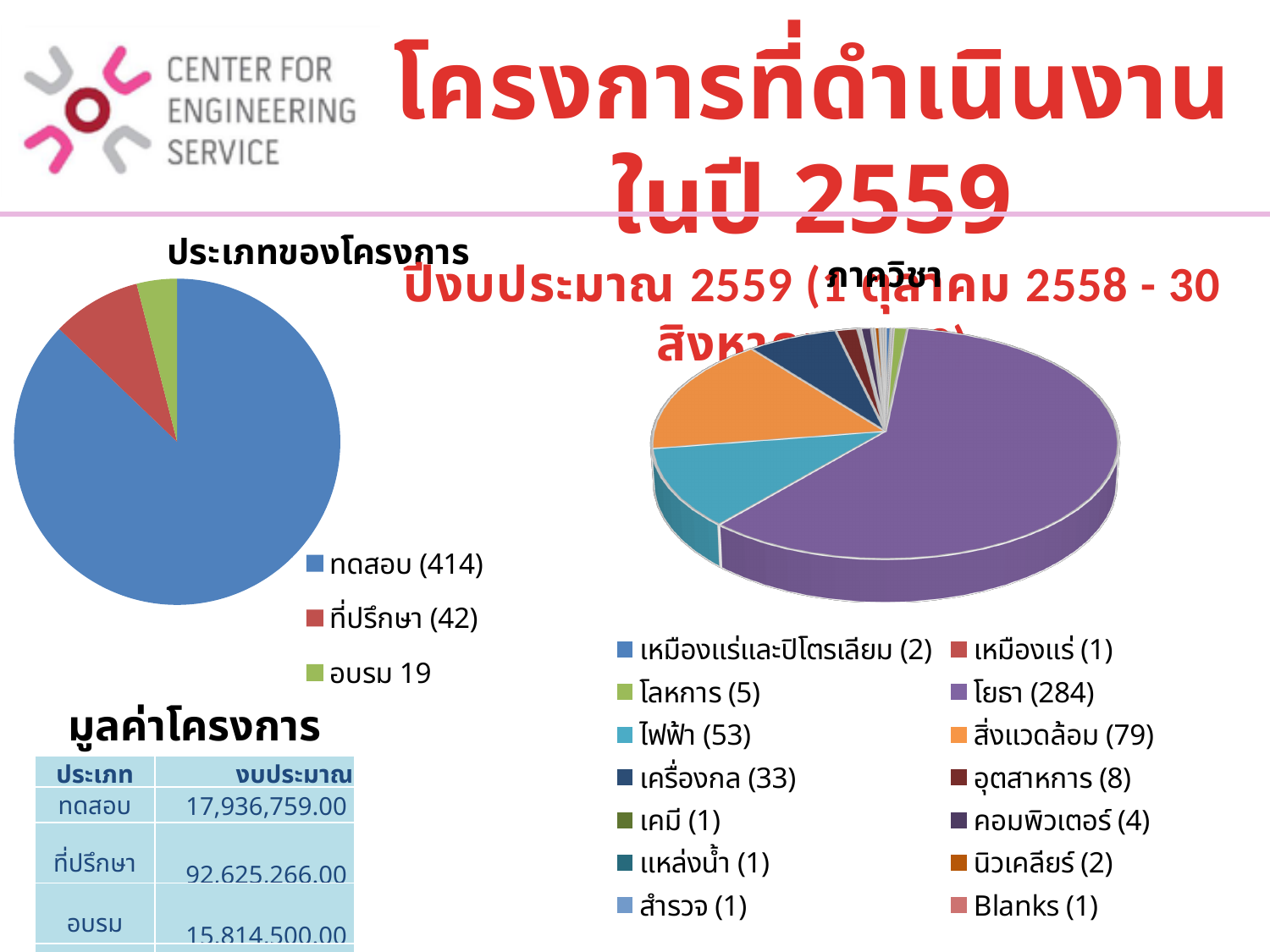
In the "ภาควิชา" chart, which category has the highest value? โยธา In the "ภาควิชา" chart, what is the difference between โยธา and สิ่งแวดล้อม? 205 In the "ประเภทของโครงการ" chart, what is the value for ที่ปรึกษา? 42 In the "ประเภทของโครงการ" chart, what is the value for ทดสอบ? 414 In the "ภาควิชา" chart, which is larger: ไฟฟ้า or เครื่องกล? ไฟฟ้า In the "ภาควิชา" chart, what is the value for เครื่องกล? 33 How many categories does the legend of the "ประเภทของโครงการ" chart list? 3 In the "ภาควิชา" chart, what is the value for สิ่งแวดล้อม? 79 How many categories does the legend of the "ภาควิชา" chart list? 14 In the "ประเภทของโครงการ" chart, which category is the smallest? อบรม In the "ประเภทของโครงการ" chart, what is the difference between ทดสอบ and ที่ปรึกษา? 372 What type of chart is the "ประเภทของโครงการ" chart on the left? Pie chart